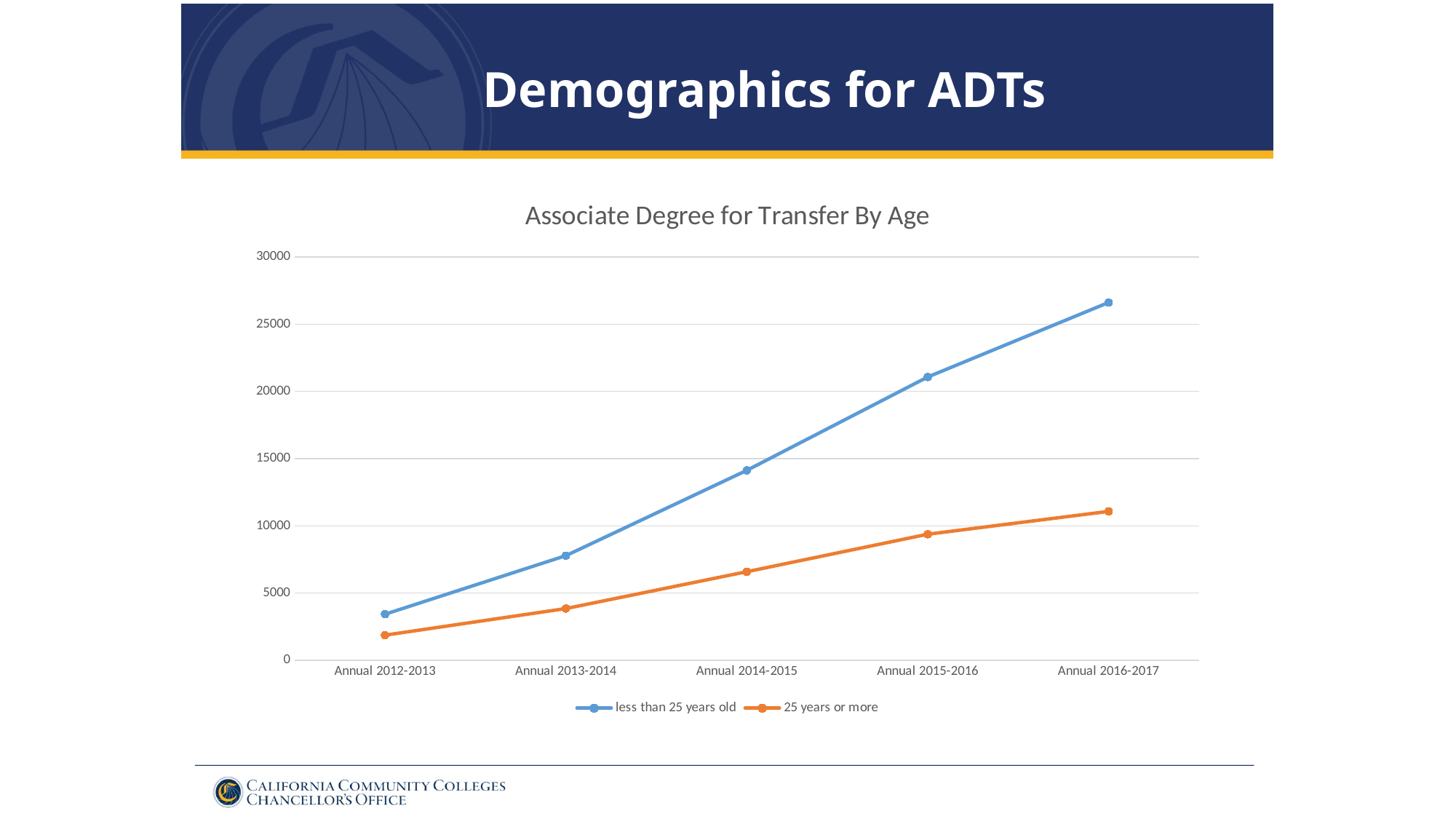
Is the value for '25 years or more' in Annual 2015-2016 greater or less than 10000? less What kind of chart is shown on the slide? line chart Do the values for 'less than 25 years old' rise or fall from Annual 2012-2013 to Annual 2016-2017? rise In which annual period is the value for '25 years or more' lowest? Annual 2012-2013 How many series does the legend list? 2 How many annual periods are shown on the x axis? 5 Which series is drawn in orange? 25 years or more Do the values for '25 years or more' rise or fall across the years shown? rise In which annual period is the value for 'less than 25 years old' highest? Annual 2016-2017 Is the value for 'less than 25 years old' in Annual 2016-2017 greater or less than 25000? greater In Annual 2015-2016, which series has the larger value: 'less than 25 years old' or '25 years or more'? less than 25 years old What is the title of the chart? Associate Degree for Transfer By Age